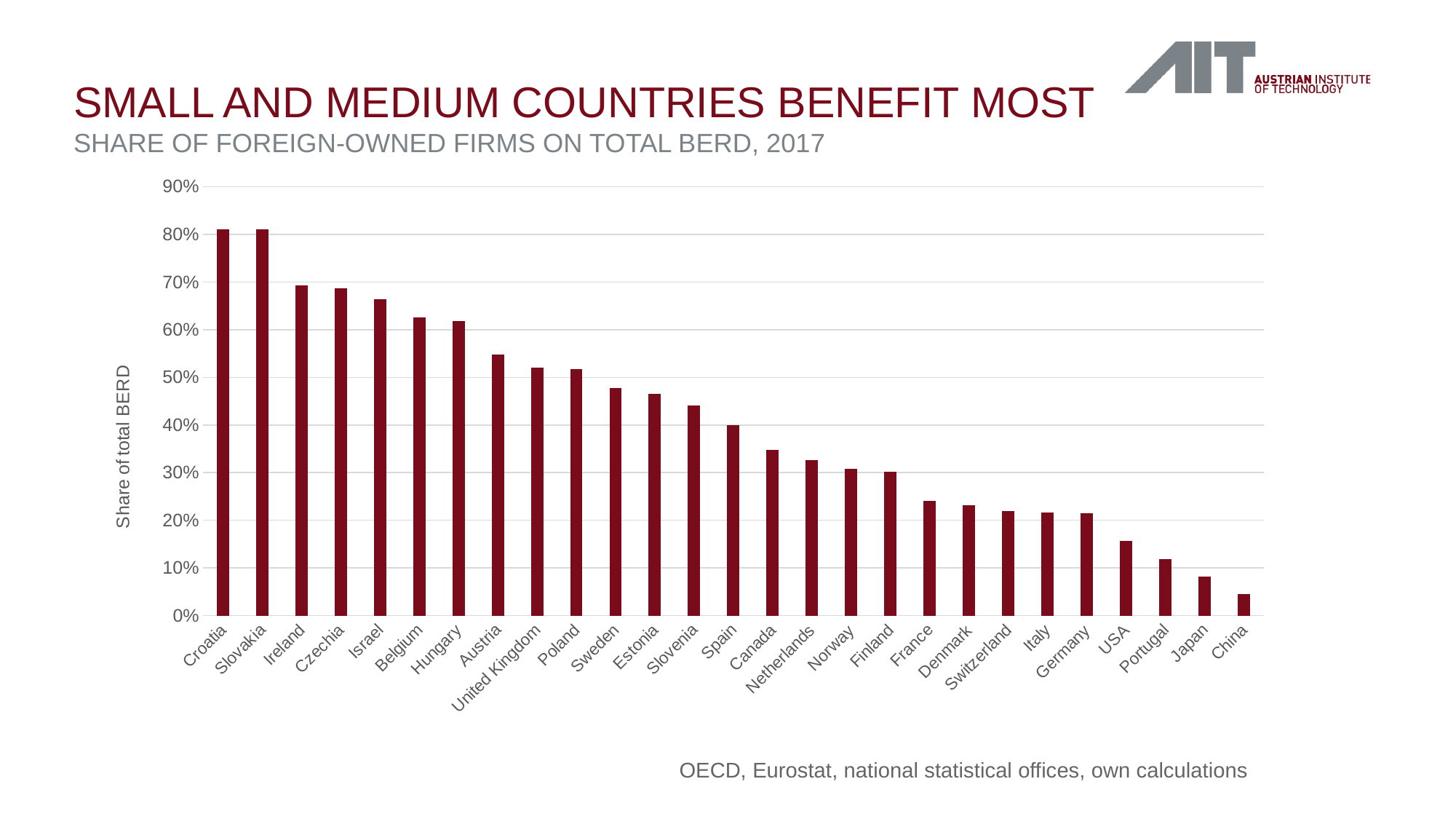
What is the label on the vertical axis of the chart? Share of total BERD What kind of chart is shown on the slide? bar chart Is the value for Israel greater or less than 60%? greater Is the value for Germany greater or less than 30%? less Which country has the lowest share of foreign-owned firms on total BERD? China How many countries are shown in the chart? 27 Is the value for China greater or less than 10%? less Which has a higher share of foreign-owned firms on total BERD, Portugal or Japan? Portugal Do the values rise or fall moving from left to right along the x axis? fall Which has a higher share of foreign-owned firms on total BERD, Ireland or Germany? Ireland